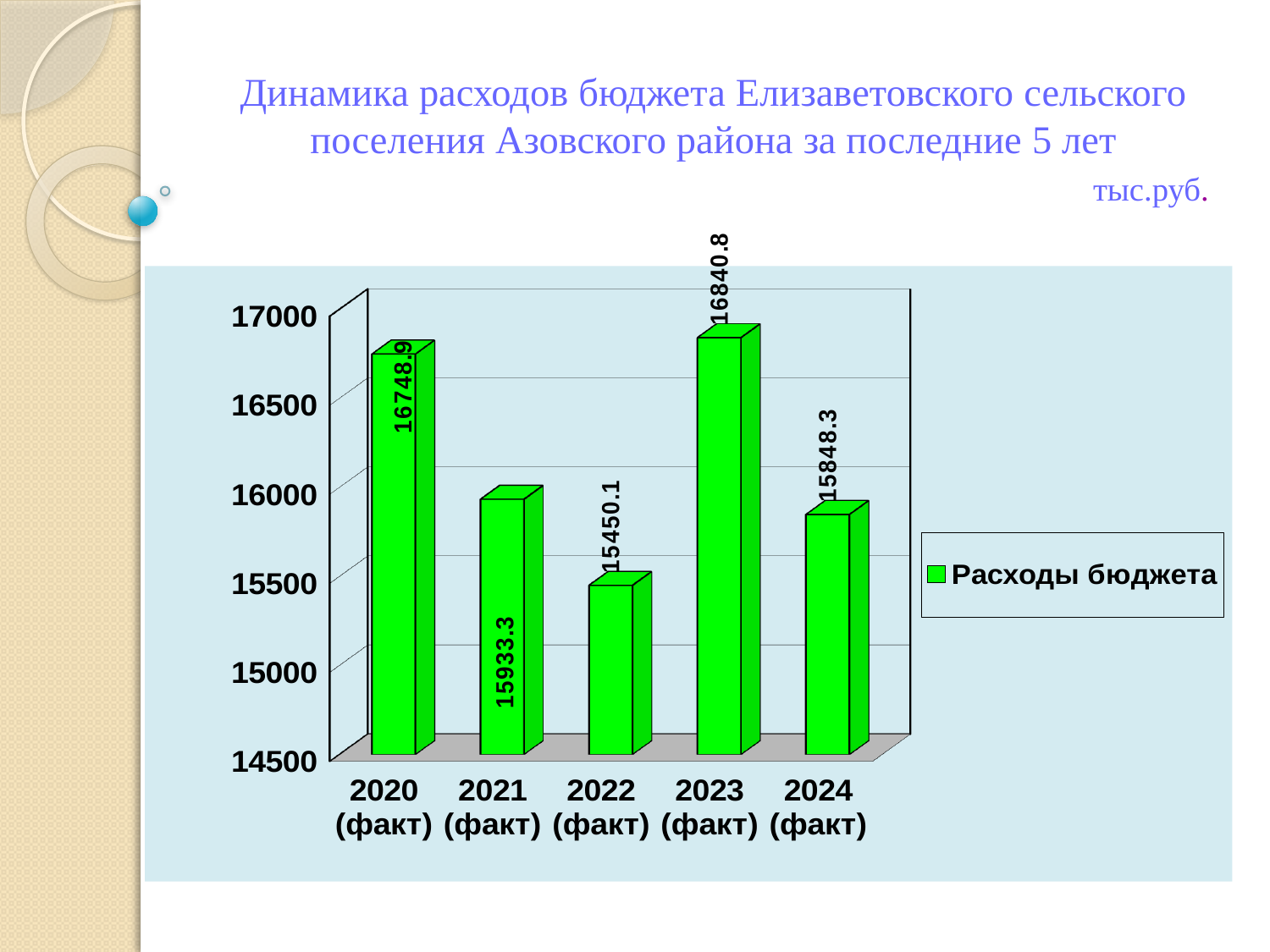
What is the value for 2022 (факт)? 15450.1 Which year has the lowest budget expenditure? 2022 (факт) How many years are shown on the x axis? 5 Is the value for 2024 (факт) greater or less than 16000? less What kind of chart is shown on the slide? bar chart Which is larger, the value for 2021 (факт) or the value for 2024 (факт)? 2021 (факт) How many series does the legend list? 1 What is the difference between the values for 2023 (факт) and 2020 (факт)? 91.9 What is the value for 2024 (факт)? 15848.3 Which year has the highest budget expenditure? 2023 (факт) What is the value for 2020 (факт)? 16748.9 What is the difference between the values for 2021 (факт) and 2022 (факт)? 483.2